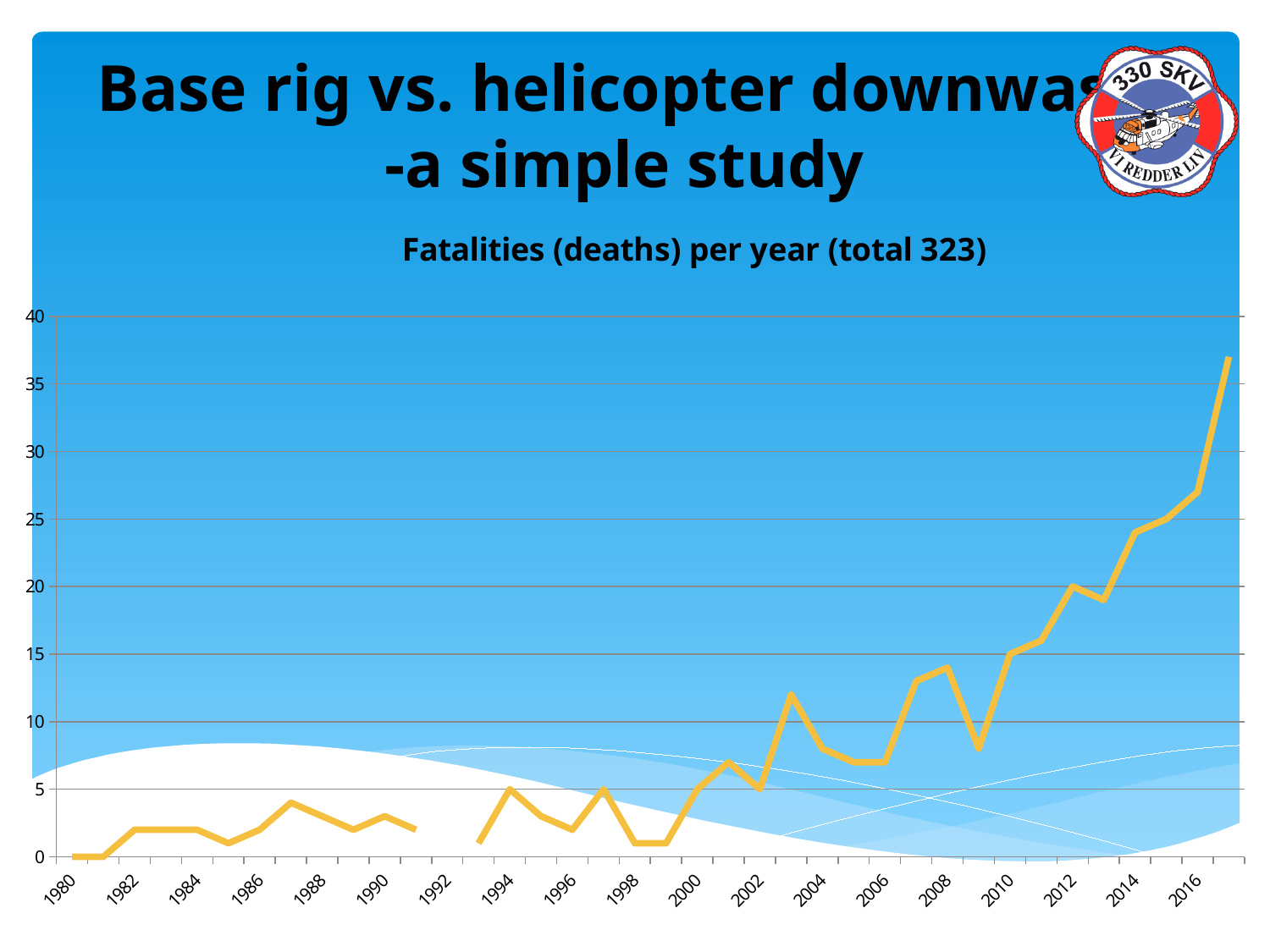
What is the title of the chart? Fatalities (deaths) per year (total 323) Is the value for 2008 greater or less than 15? less Is the value for 2016 greater or less than 25? greater Which year has the larger value, 2003 or 2005? 2003 Is the value for 1980 greater or less than 5? less What kind of chart is shown on the slide? line chart Which year has the larger value, 2008 or 2009? 2008 Overall, do the values rise or fall from 1980 to the end of the x axis? rise What total number of fatalities is stated in the chart title? 323 How many year labels are printed along the x axis? 19